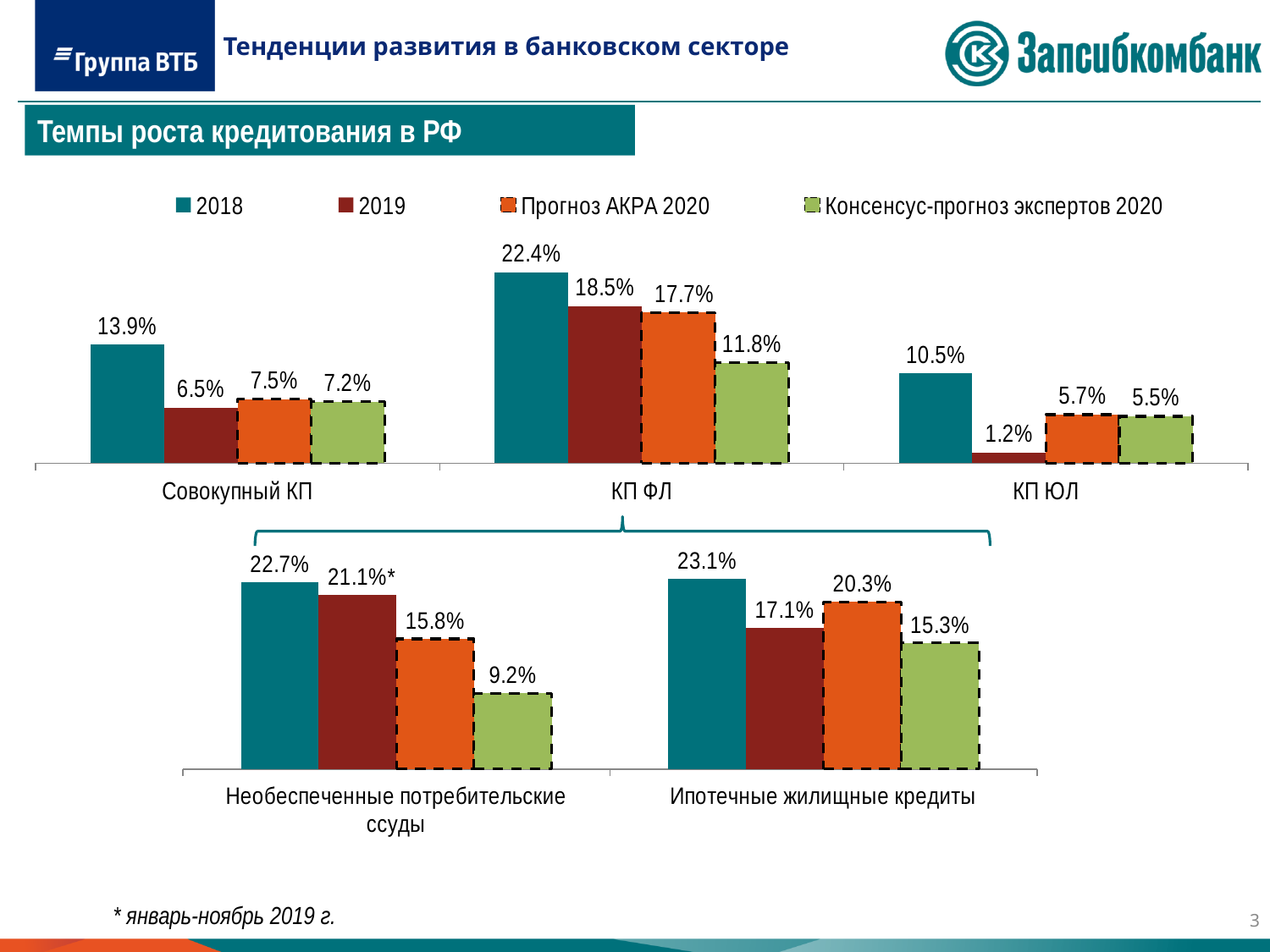
In the top chart, which category has the highest 2018 value? КП ФЛ In the bottom chart, what is the 2019 value for Ипотечные жилищные кредиты? 17.1% In the top chart, what is the Прогноз АКРА 2020 value for Совокупный КП? 7.5% In the top chart, what is the difference between the 2018 and 2019 values for Совокупный КП? 7.4% What type of chart is the top chart? Bar chart In the top chart, what is the 2018 value for КП ФЛ? 22.4% In the bottom chart, which is larger for Ипотечные жилищные кредиты: the Прогноз АКРА 2020 value or the Консенсус-прогноз экспертов 2020 value? Прогноз АКРА 2020 How many categories are shown in the bottom chart? 2 In the top chart, which category has the lowest 2019 value? КП ЮЛ How many series does the legend list? 4 In the top chart, what is the 2019 value for КП ЮЛ? 1.2% In the bottom chart, what is the Консенсус-прогноз экспертов 2020 value for Необеспеченные потребительские ссуды? 9.2%